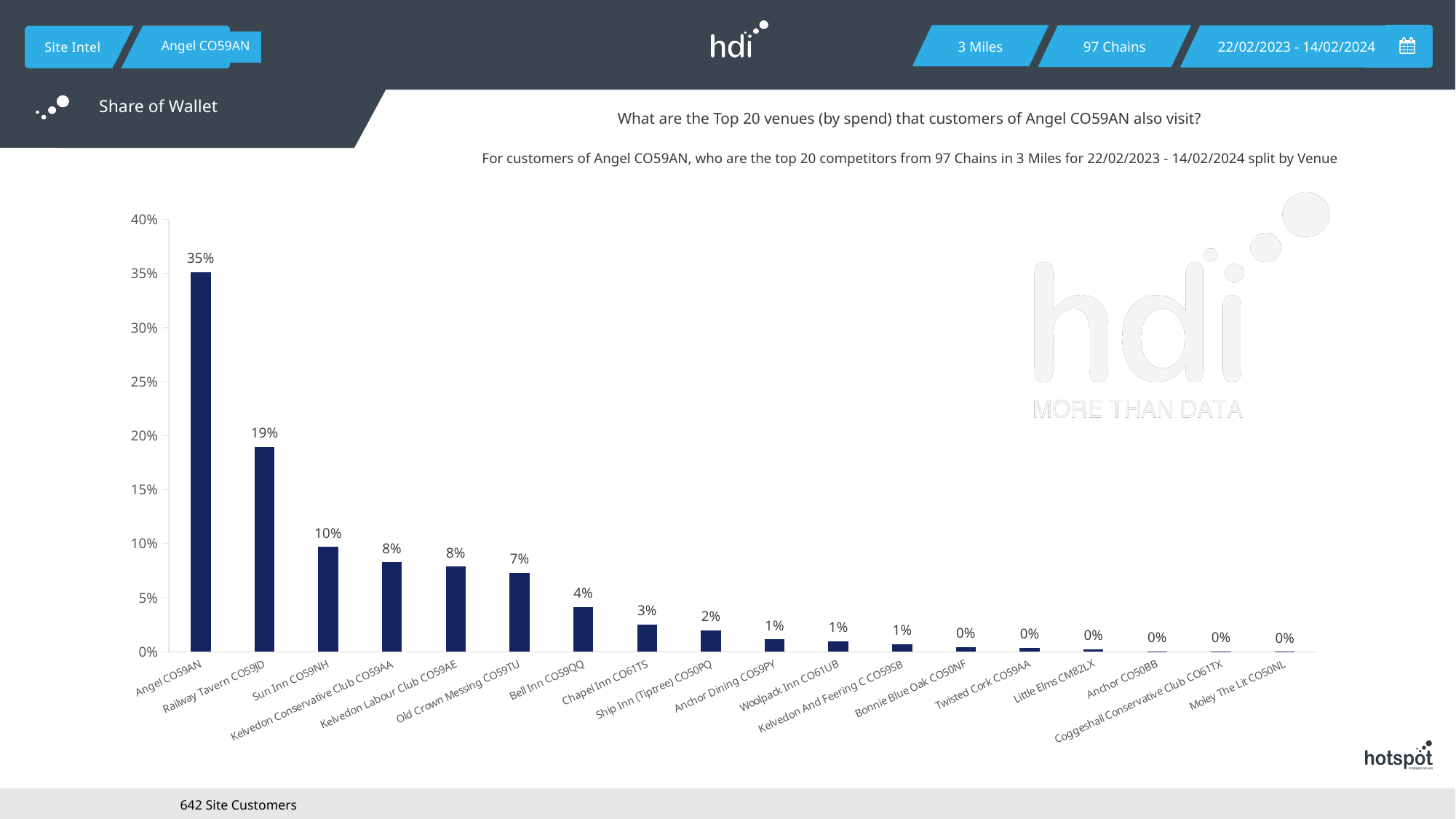
What is the value for Railway Tavern CO59JD? 19% How many venues are shown on the chart? 18 What is the value for Old Crown Messing CO59TU? 7% What is the value for Angel CO59AN? 35% What kind of chart is shown on the slide? bar chart What is the difference between the values for Sun Inn CO59NH and Bell Inn CO59QQ? 6% What is the value for Chapel Inn CO61TS? 3% Do the values rise or fall from left to right along the x axis? fall Which venue has the highest share of wallet? Angel CO59AN Which is larger, the value for Railway Tavern CO59JD or Sun Inn CO59NH? Railway Tavern CO59JD Is the value for Angel CO59AN greater or less than 30%? greater What is the difference between the values for Angel CO59AN and Railway Tavern CO59JD? 16%